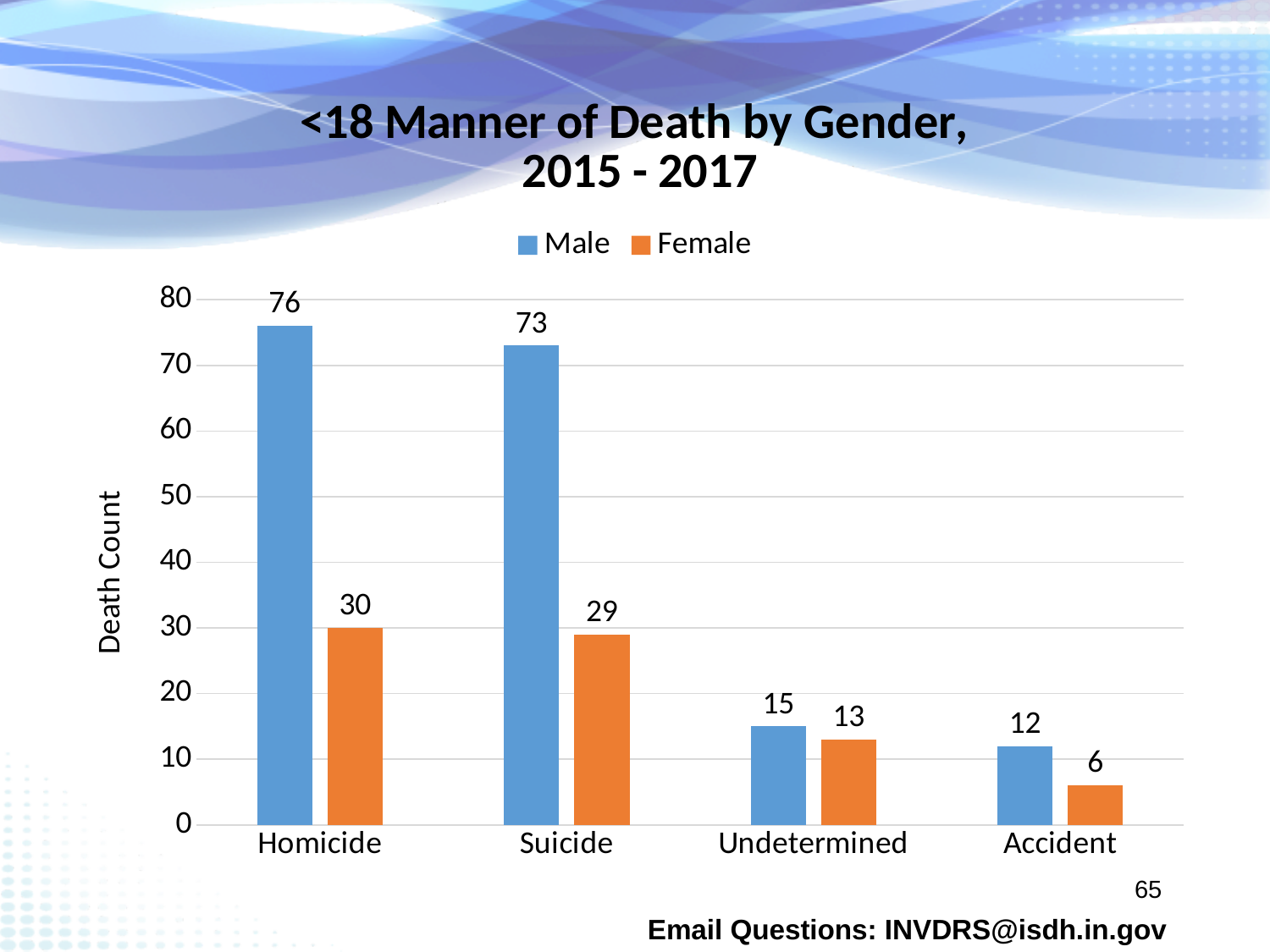
What kind of chart is shown on the slide? Bar chart What is the title of the chart? <18 Manner of Death by Gender, 2015 - 2017 What is the difference between the Male death counts for Undetermined and Accident? 3 How many manner-of-death categories are shown on the x axis? 4 What is the Female death count for Suicide? 29 Which manner of death has the lowest Female death count? Accident What is the Male death count for Homicide? 76 Which manner of death has the highest Male death count? Homicide What is the Female death count for Accident? 6 What is the difference between the Male and Female death counts for Homicide? 46 Which is larger, the Female death count for Homicide or the Female death count for Suicide? Homicide How many series does the legend list? 2